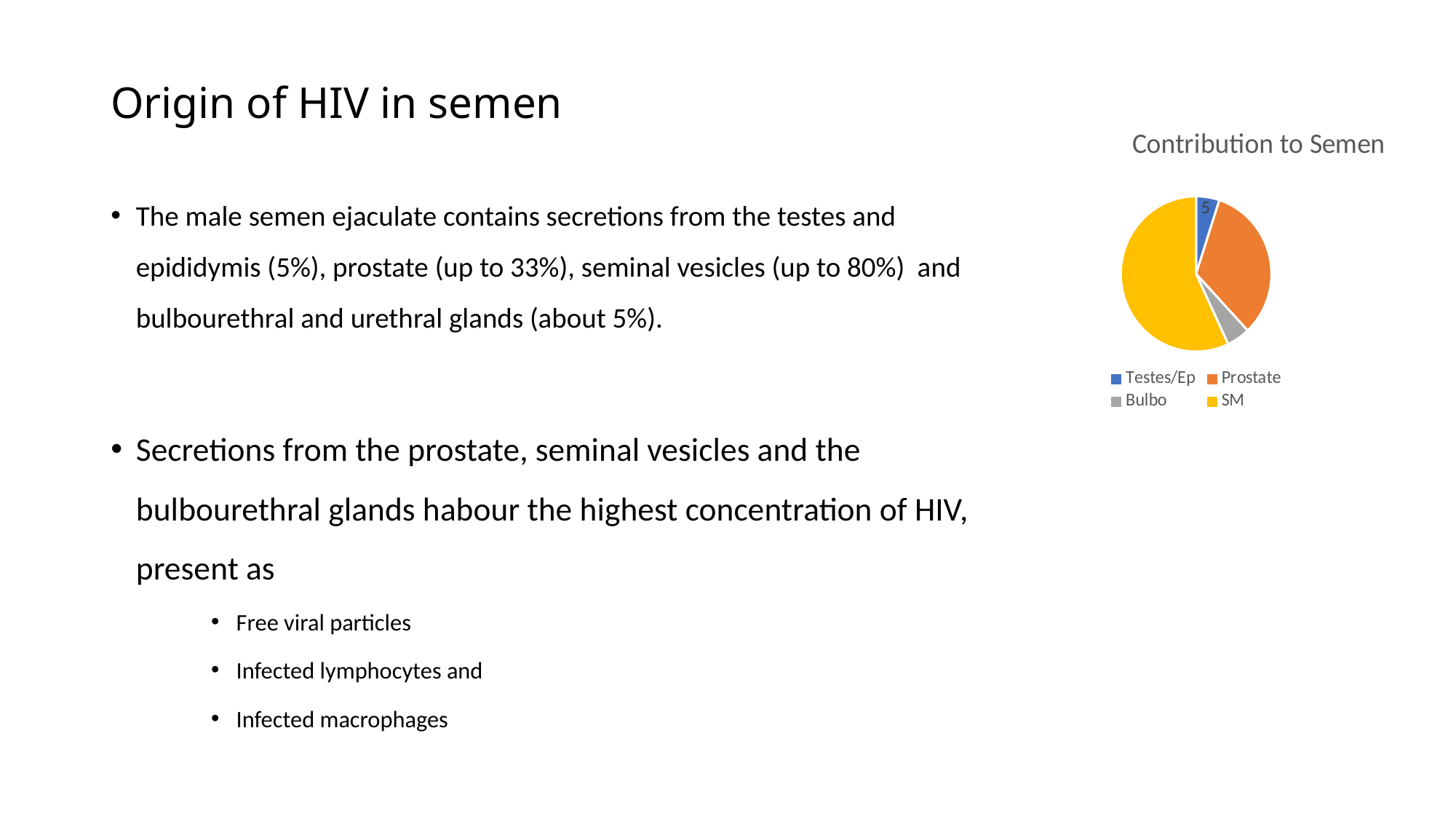
How many slices does the pie chart have? 4 Which slice is larger in the pie chart, SM or Testes/Ep? SM What value is labelled on the Testes/Ep slice of the pie chart? 5 What kind of chart is shown on the slide? pie chart What is the title of the chart? Contribution to Semen Which slice is larger in the pie chart, Prostate or Bulbo? Prostate Which category has the largest slice in the pie chart? SM How many entries does the chart legend list? 4 What colour is the SM slice in the pie chart? yellow Which slice is larger in the pie chart, SM or Prostate? SM